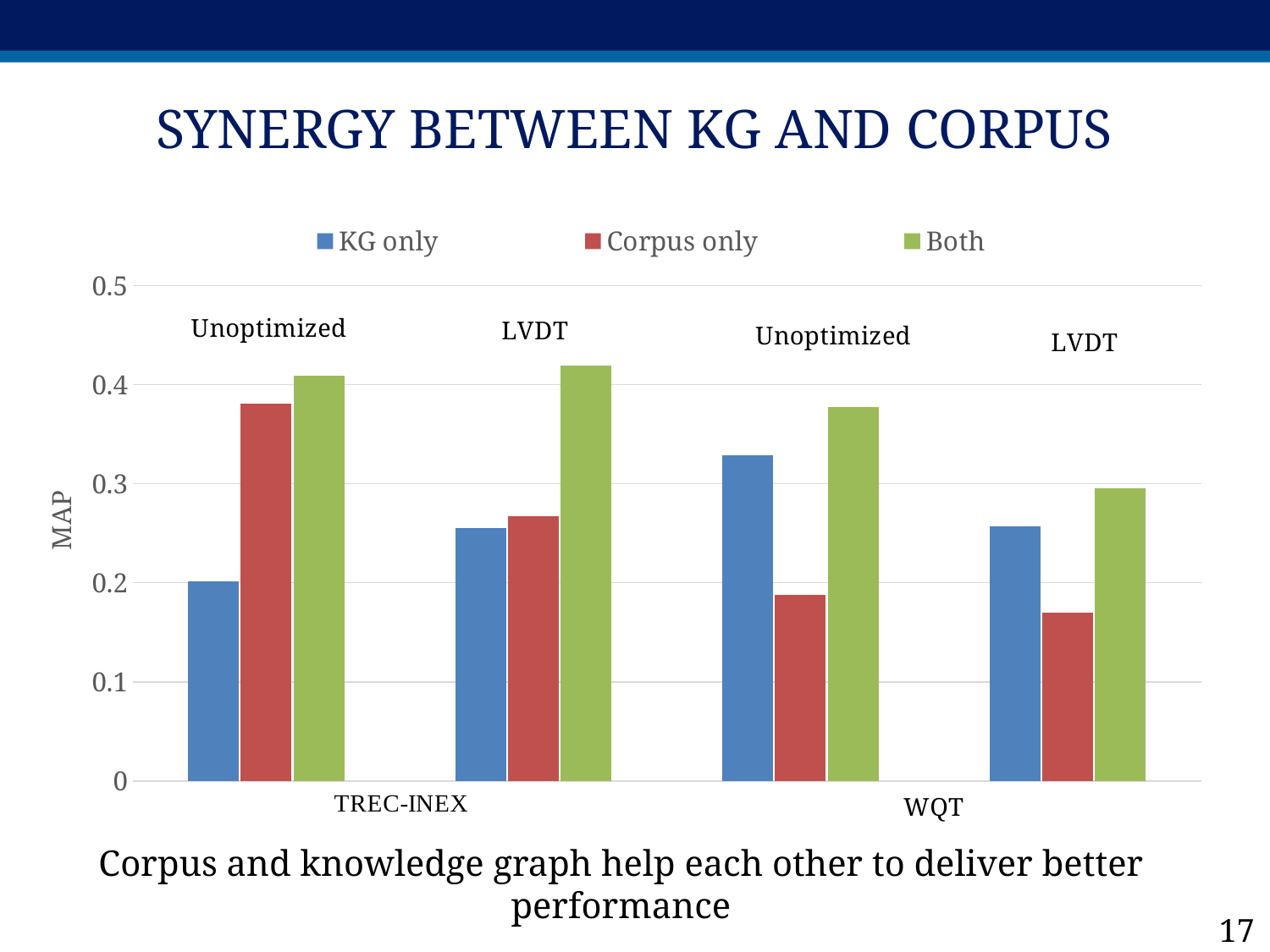
Is the Corpus only value for WQT LVDT greater or less than 0.2? less How many series does the legend list? 3 In the WQT Unoptimized group, which is larger: KG only or Corpus only? KG only What kind of chart is shown on the slide? bar chart In the TREC-INEX Unoptimized group, which is larger: KG only or Corpus only? Corpus only Is the KG only value for TREC-INEX Unoptimized greater or less than 0.3? less Is the Both value for TREC-INEX LVDT greater or less than 0.4? greater Which series has the highest bar in every group? Both What are the three series named in the legend? KG only, Corpus only, Both What is the label on the vertical axis? MAP In the WQT LVDT group, which series has the lowest bar? Corpus only